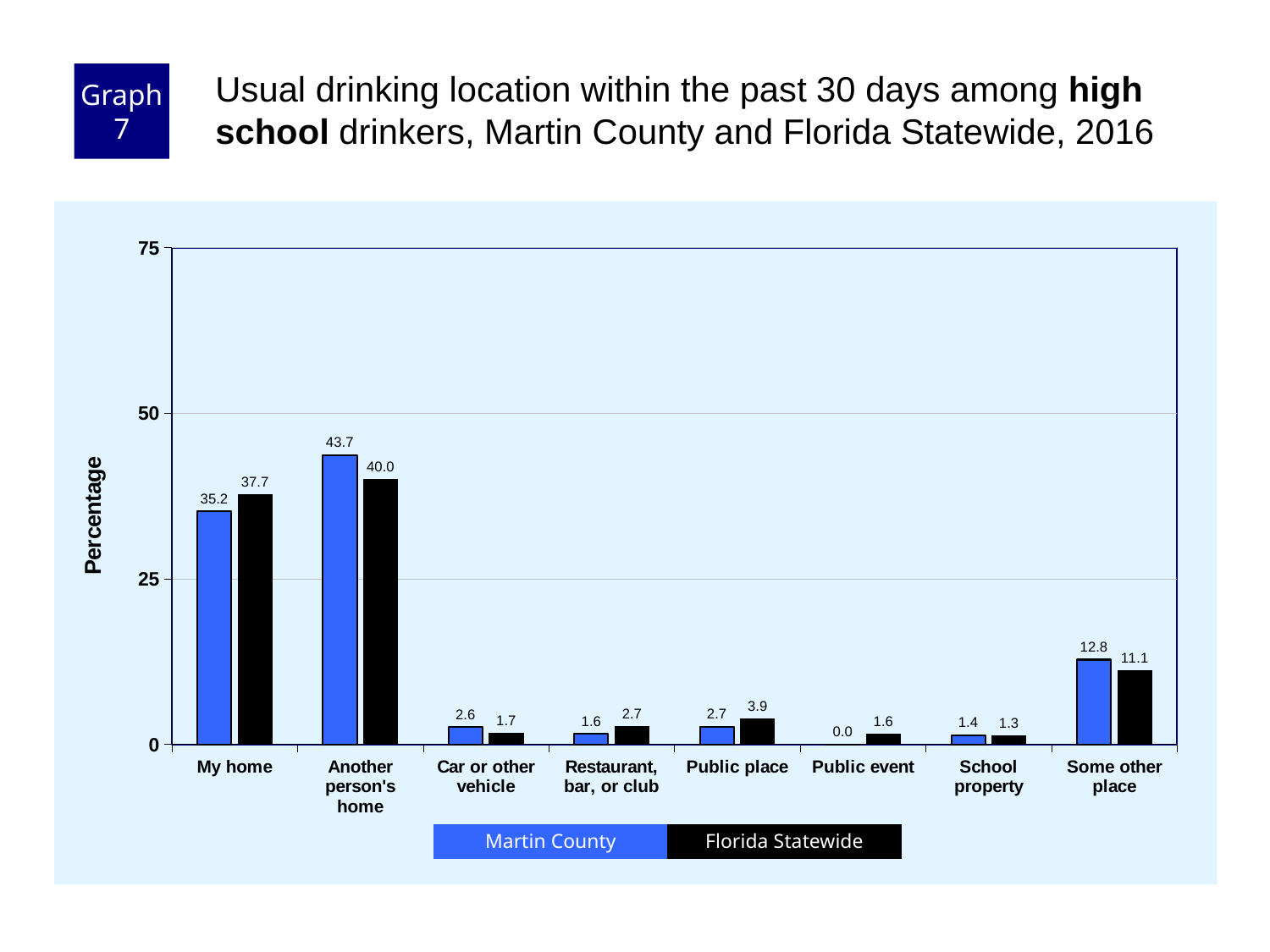
What kind of chart is shown on the slide? Bar chart What is the Florida Statewide value for "My home"? 37.7 Which category has the lowest Florida Statewide value? School property What is the Martin County value for "Public event"? 0.0 Is the Martin County value for "My home" greater or less than 25? greater How many location categories are shown on the x axis? 8 What is the difference between the Martin County and Florida Statewide values for "Another person's home"? 3.7 Which is larger for "Public place": Martin County or Florida Statewide? Florida Statewide What is the label of the y axis? Percentage What is the Martin County value for "Another person's home"? 43.7 How many series does the legend list? 2 Which category has the highest Martin County value? Another person's home